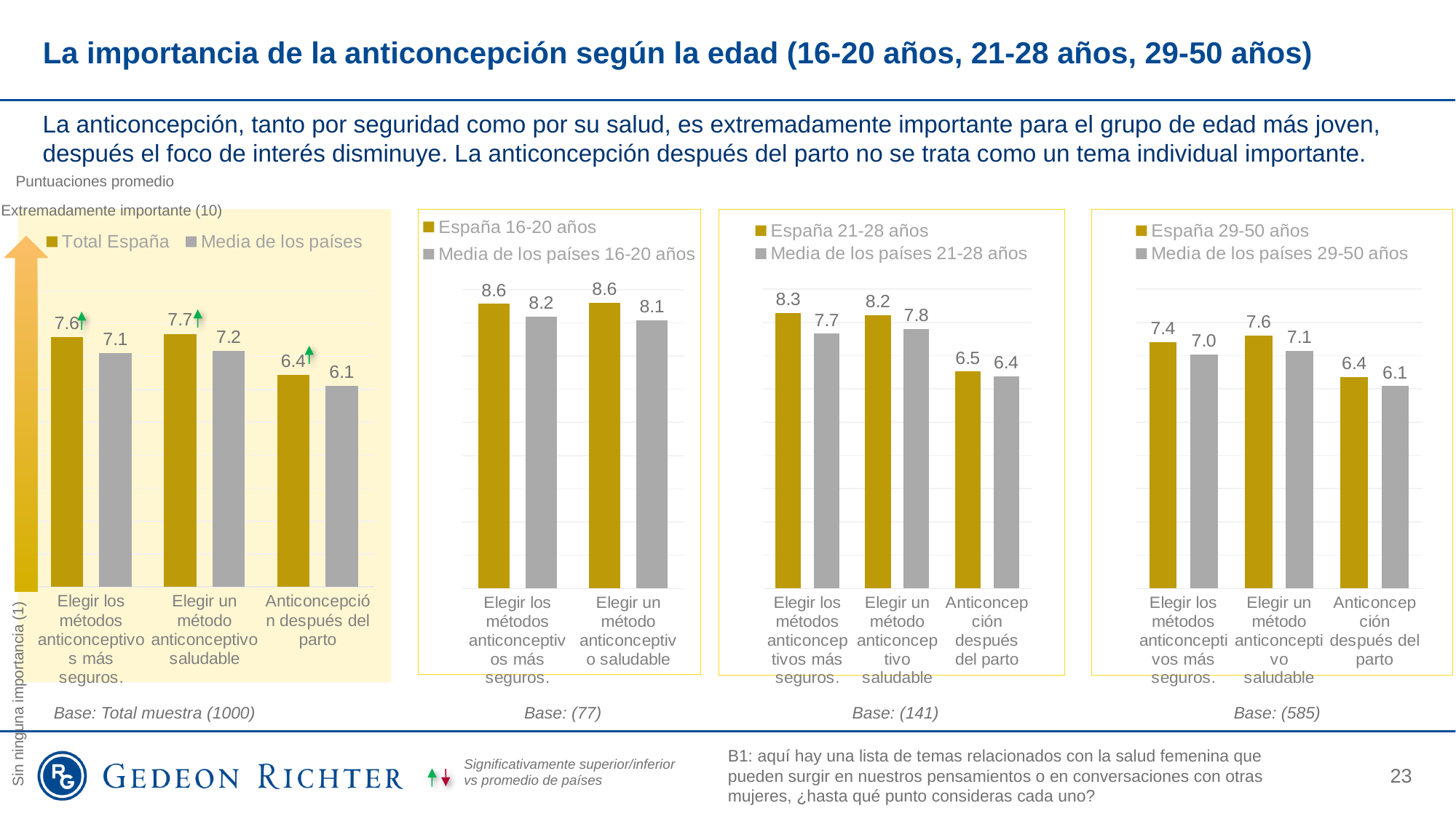
In the leftmost chart (Total España vs Media de los países), what is the value for Total España for 'Anticoncepción después del parto'? 6.4 How many series does the legend of the leftmost chart list? 2 In the second chart from the left (España 16-20 años), what is the value for España 16-20 años for 'Elegir los métodos anticonceptivos más seguros'? 8.6 In the leftmost chart, which category has the highest value for Total España? Elegir un método anticonceptivo saludable In the second chart from the left (16-20 años), how many categories are shown on the x axis? 2 What type of chart is used in the third chart from the left (21-28 años)? Bar chart In the third chart from the left (21-28 años), what is the difference between España 21-28 años and Media de los países 21-28 años for 'Elegir los métodos anticonceptivos más seguros'? 0.6 In the rightmost chart (España 29-50 años), which category has the lowest value for España 29-50 años? Anticoncepción después del parto In the rightmost chart (29-50 años), what is the value for España 29-50 años for 'Elegir un método anticonceptivo saludable'? 7.6 In the third chart from the left (España 21-28 años), what is the value for Media de los países 21-28 años for 'Anticoncepción después del parto'? 6.4 In the rightmost chart (29-50 años), which is larger for 'Elegir los métodos anticonceptivos más seguros': España 29-50 años or Media de los países 29-50 años? España 29-50 años In the leftmost chart, what is the value for Media de los países for 'Elegir un método anticonceptivo saludable'? 7.2